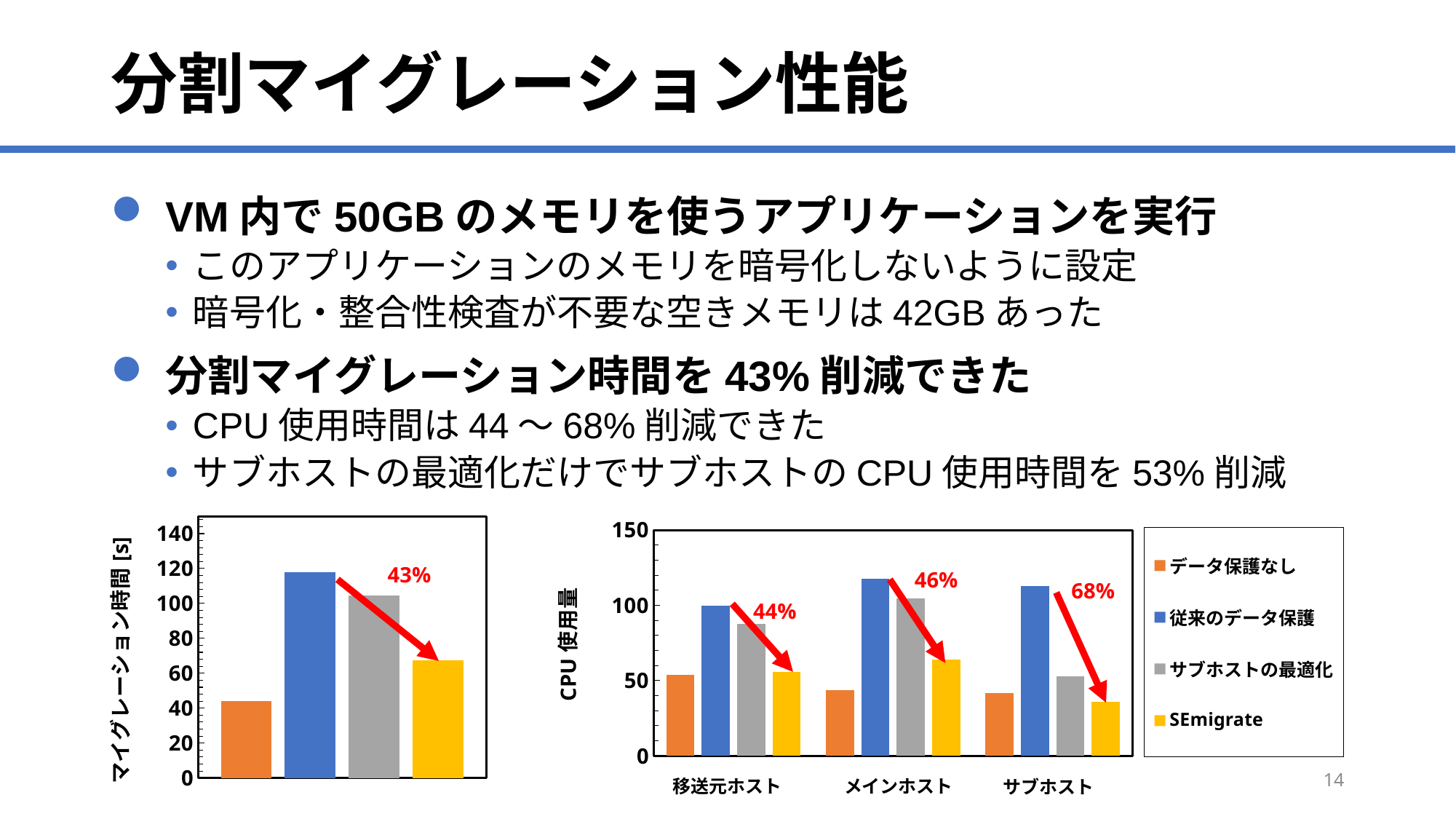
How many series does the legend on the slide list? 4 In the right chart (CPU 使用量), is the value for SEmigrate at サブホスト greater or less than 50? less In the right chart (CPU 使用量), how many host categories are shown on the x axis? 3 In the left chart (マイグレーション時間 [s]), is the value for SEmigrate greater or less than 80? less In the left chart (マイグレーション時間 [s]), is the value for 従来のデータ保護 greater or less than 100? greater In the right chart (CPU 使用量), for メインホスト, which is larger: 従来のデータ保護 or サブホストの最適化? 従来のデータ保護 In the right chart (CPU 使用量), which series has the highest value for サブホスト? 従来のデータ保護 In the left chart (マイグレーション時間 [s]), which series has the lowest migration time? データ保護なし In the right chart (CPU 使用量), which series has the lowest value for メインホスト? データ保護なし What kind of chart is the left chart (マイグレーション時間 [s])? bar chart In the right chart (CPU 使用量), what percentage reduction is annotated above the サブホスト bars? 68% In the left chart (マイグレーション時間 [s]), which series has the highest migration time? 従来のデータ保護